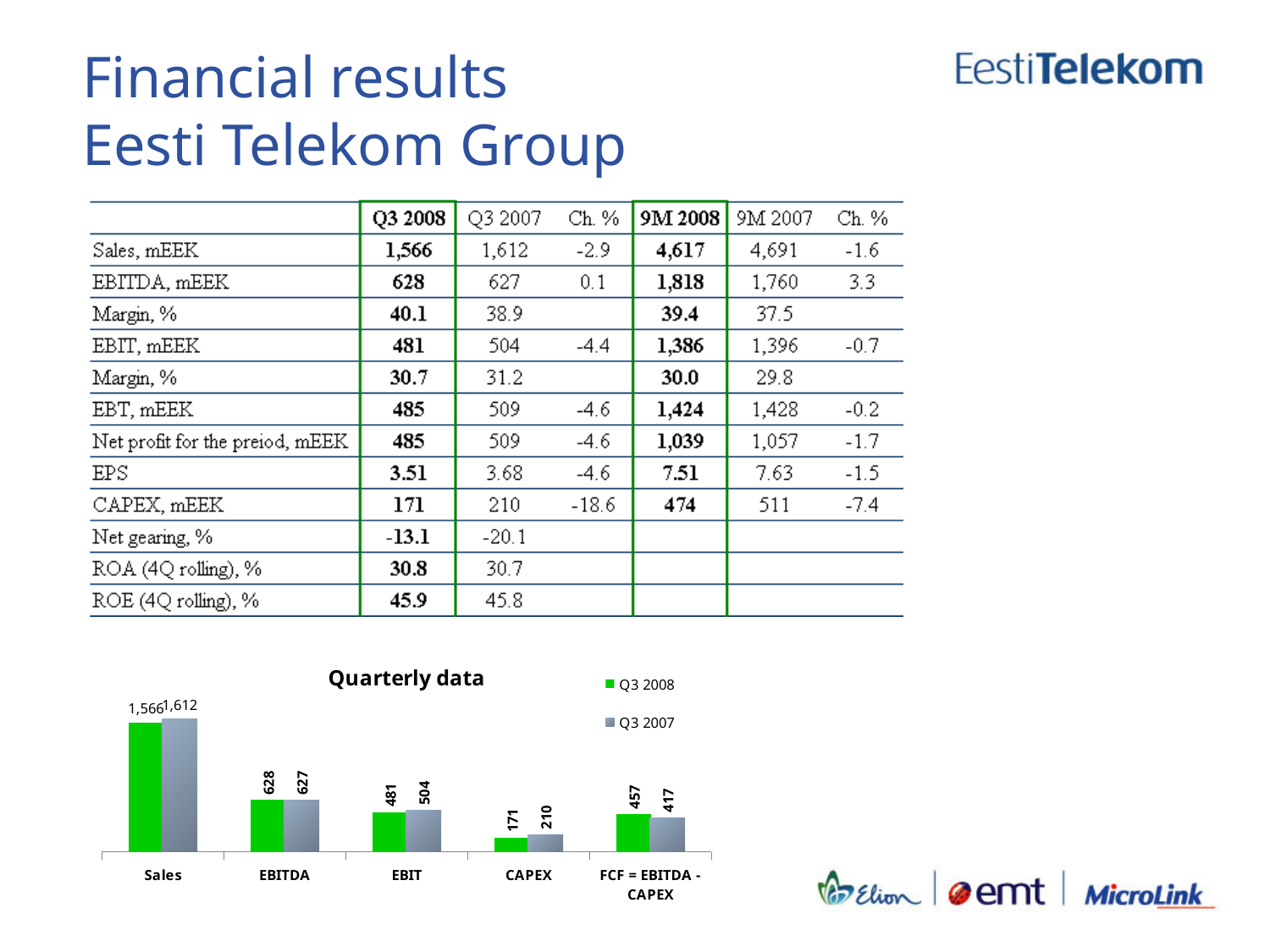
In the Quarterly data chart, what is the Q3 2007 value for CAPEX? 210 In the Quarterly data chart, what is the difference between the Q3 2007 and Q3 2008 values for EBIT? 23 In the Quarterly data chart, which is larger for FCF = EBITDA - CAPEX: the Q3 2008 value or the Q3 2007 value? Q3 2008 In the Quarterly data chart, what is the Q3 2008 value for Sales? 1,566 In the Quarterly data chart, which category has the lowest Q3 2007 value? CAPEX How many series does the legend of the Quarterly data chart list? 2 What type of chart is the Quarterly data chart? Bar chart In the Quarterly data chart, what is the difference between the Q3 2008 and Q3 2007 values for FCF = EBITDA - CAPEX? 40 In the Quarterly data chart, what is the Q3 2008 value for FCF = EBITDA - CAPEX? 457 How many categories are shown on the x axis of the Quarterly data chart? 5 In the Quarterly data chart, which category has the highest Q3 2008 value? Sales In the Quarterly data chart, which is larger for CAPEX: the Q3 2008 value or the Q3 2007 value? Q3 2007